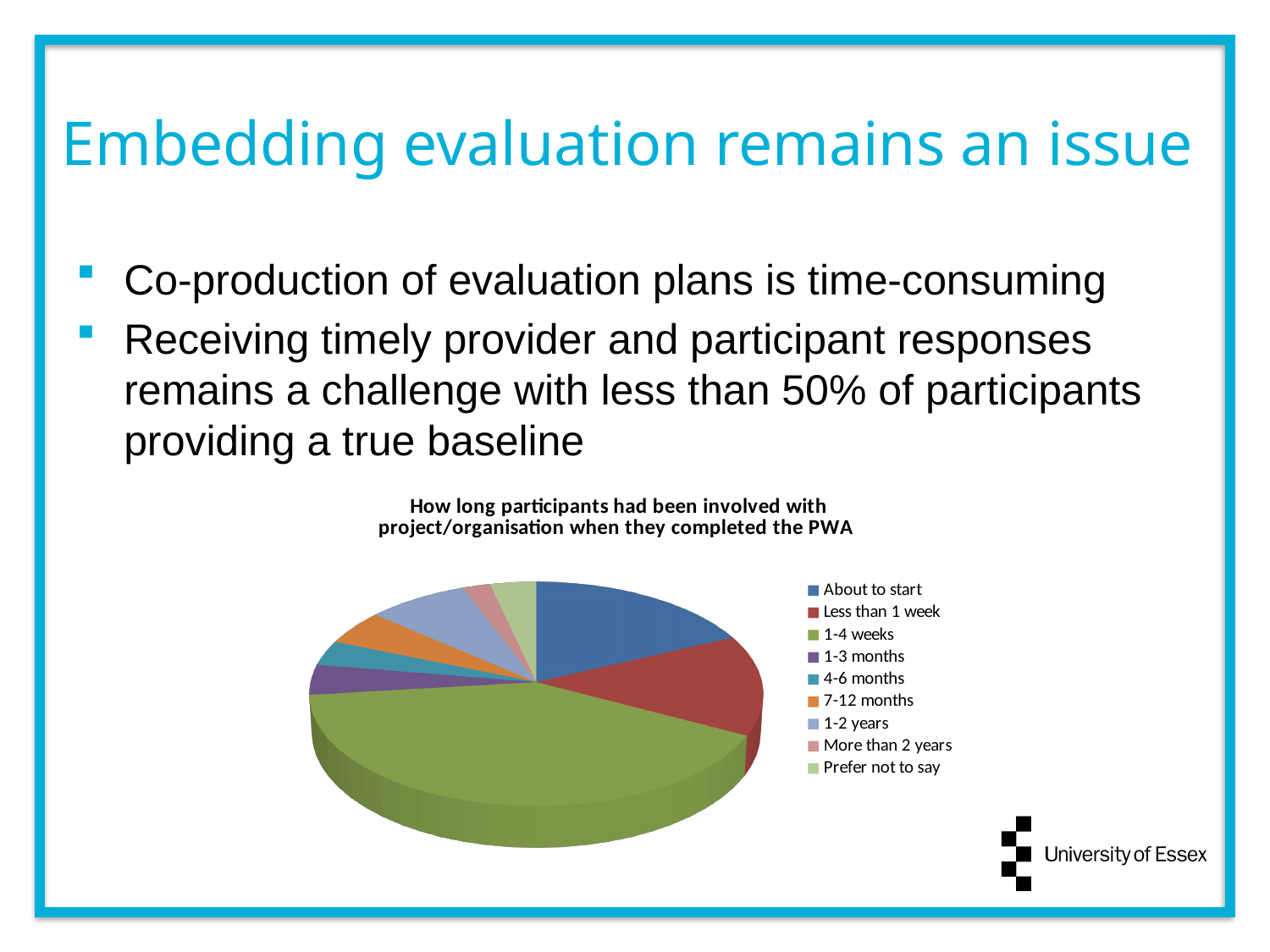
Which category has the largest slice in the pie chart? 1-4 weeks Which category is listed last in the pie chart's legend? Prefer not to say What colour is the 1-4 weeks slice in the pie chart? Green Which slice is larger in the pie chart: 1-4 weeks or Less than 1 week? 1-4 weeks How many categories does the pie chart's legend list? 9 Which slice is larger in the pie chart: 1-4 weeks or About to start? 1-4 weeks What kind of chart is shown on the slide? Pie chart What is the title of the pie chart? How long participants had been involved with project/organisation when they completed the PWA Which category is listed first in the pie chart's legend? About to start Which slice is larger in the pie chart: About to start or 1-3 months? About to start